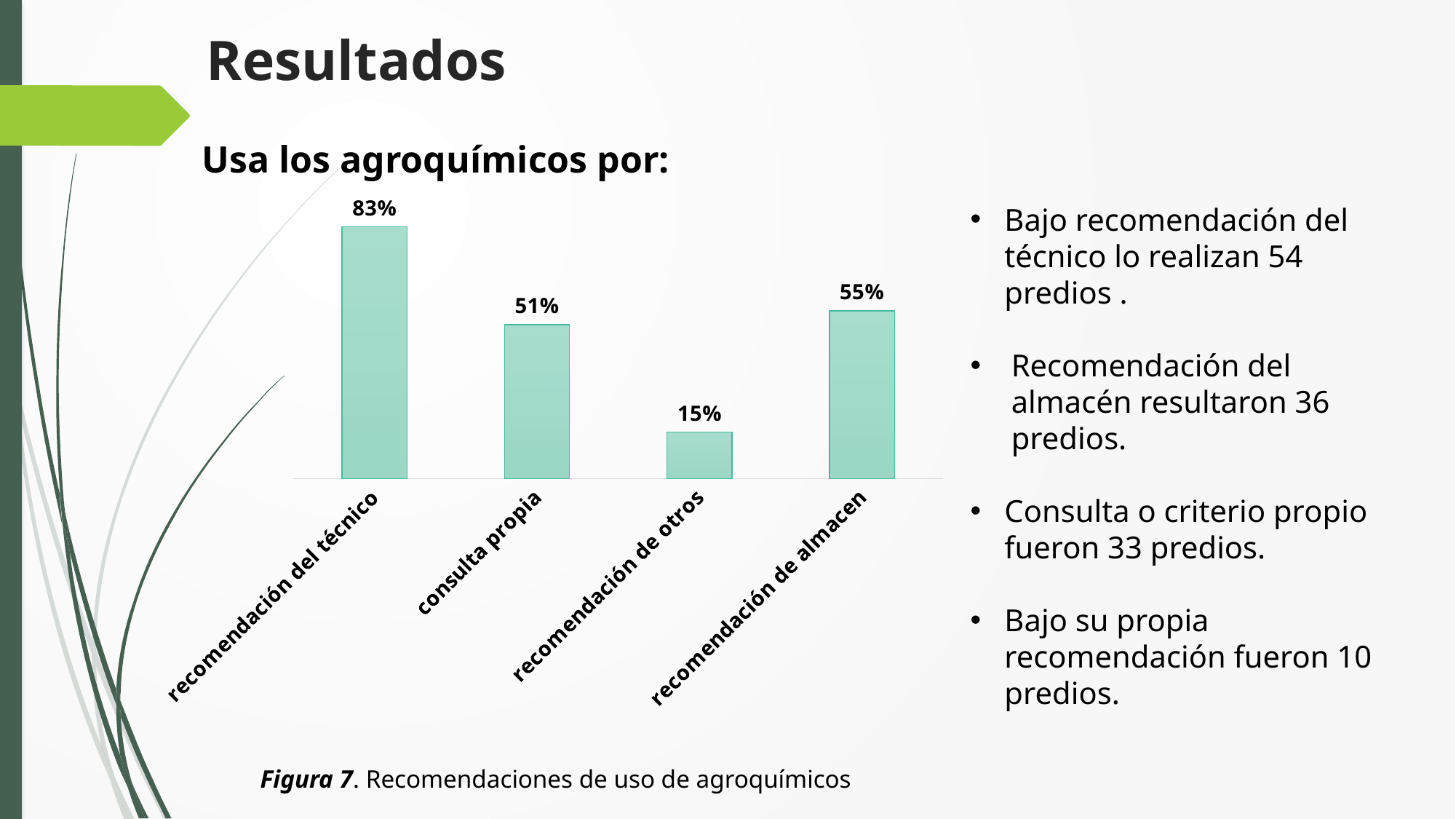
What is the figure caption below the chart? Figura 7. Recomendaciones de uso de agroquímicos Which category has the lowest value? recomendación de otros Which is larger, 'consulta propia' or 'recomendación de almacen'? recomendación de almacen What is the difference between 'recomendación de almacen' and 'recomendación de otros'? 40% What kind of chart is shown on the slide? bar chart What is the value for 'recomendación de otros'? 15% What is the value for 'recomendación de almacen'? 55% Which category has the highest value? recomendación del técnico How many categories are shown in the chart? 4 What is the difference between 'recomendación del técnico' and 'consulta propia'? 32% What is the value for 'consulta propia'? 51% What is the value for 'recomendación del técnico'? 83%